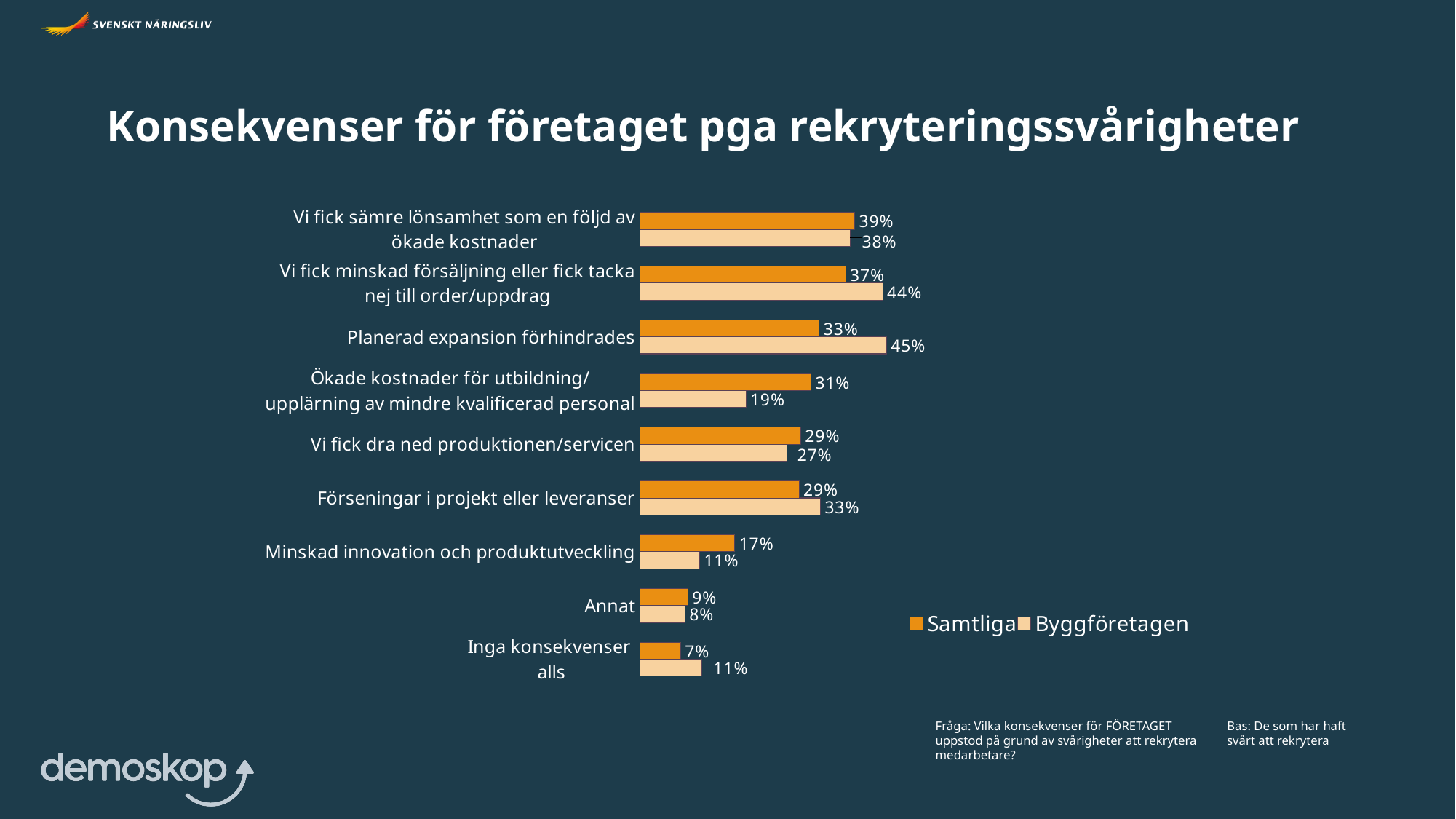
What kind of chart is shown on the slide? Bar chart What is the Byggföretagen value for "Minskad innovation och produktutveckling"? 11% Which category has the highest Samtliga value? Vi fick sämre lönsamhet som en följd av ökade kostnader What is the Byggföretagen value for "Planerad expansion förhindrades"? 45% How many series does the legend list? 2 How many categories are shown in the chart? 9 What is the Samtliga value for "Planerad expansion förhindrades"? 33% Which category has the highest Byggföretagen value? Planerad expansion förhindrades Which category has the lowest Samtliga value? Inga konsekvenser alls What is the difference between the Byggföretagen and Samtliga values for "Ökade kostnader för utbildning/upplärning av mindre kvalificerad personal"? 12% Which series is shown in the darker orange colour? Samtliga For "Vi fick minskad försäljning eller fick tacka nej till order/uppdrag", which series has the larger value, Samtliga or Byggföretagen? Byggföretagen